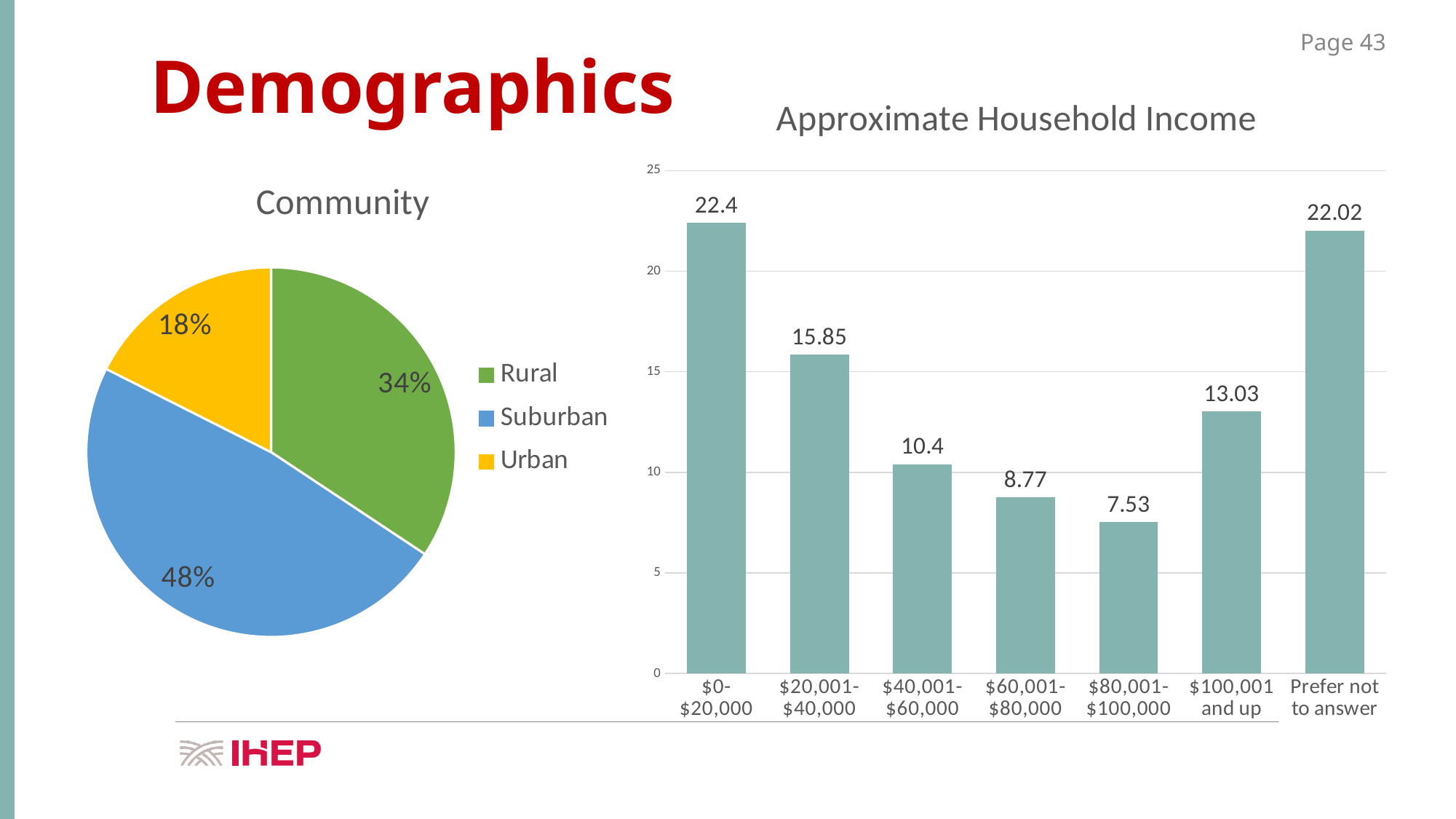
In the Approximate Household Income chart, which is larger: $40,001-$60,000 or $60,001-$80,000? $40,001-$60,000 In the Community pie chart, what share is Suburban? 48% In the Community chart, what colour is the Rural slice? Green In the Community pie chart, how many categories does the legend list? 3 In the Approximate Household Income chart, what is the difference between $0-$20,000 and $100,001 and up? 9.37 In the Approximate Household Income chart, what is the value for $20,001-$40,000? 15.85 What kind of chart is the Approximate Household Income chart? Bar chart In the Community pie chart, which category has the largest share? Suburban In the Approximate Household Income chart, what is the value for Prefer not to answer? 22.02 In the Community pie chart, what share is Urban? 18% In the Community pie chart, which category has the smallest share? Urban In the Approximate Household Income chart, which category has the lowest value? $80,001-$100,000